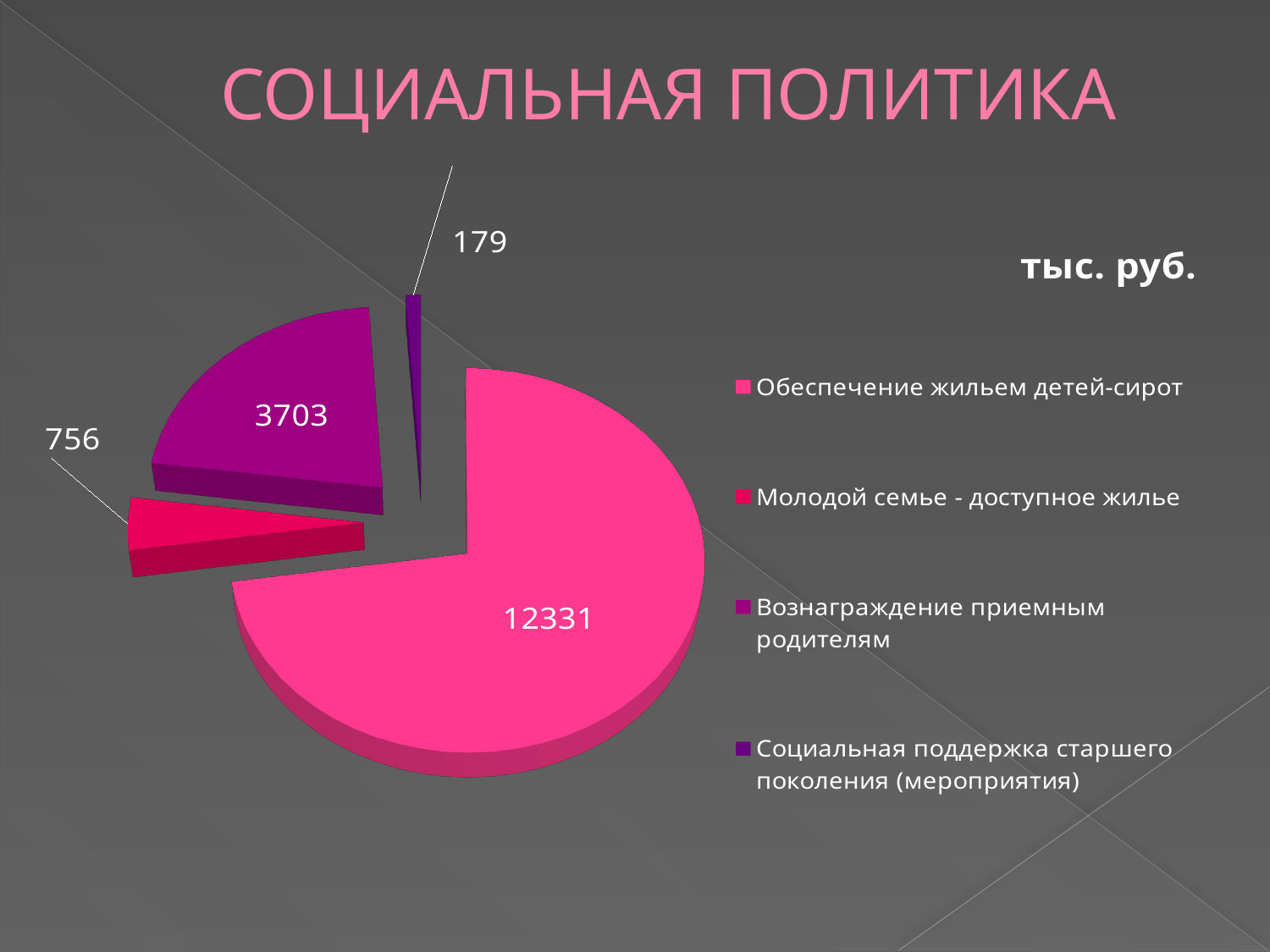
What is the difference between the values for Молодой семье - доступное жилье and Социальная поддержка старшего поколения (мероприятия)? 577 Which category has the smallest slice of the pie? Социальная поддержка старшего поколения (мероприятия) What is the value for Молодой семье - доступное жилье? 756 What type of chart is shown on the slide? Pie chart What is the difference between the values for Обеспечение жильем детей-сирот and Вознаграждение приемным родителям? 8628 How many slices does the pie chart have? 4 What is the value for Вознаграждение приемным родителям? 3703 Which is larger: the value for Вознаграждение приемным родителям or the value for Молодой семье - доступное жилье? Вознаграждение приемным родителям What is the value for Социальная поддержка старшего поколения (мероприятия)? 179 What unit is indicated for the values on the chart? тыс. руб. Which category has the largest slice of the pie? Обеспечение жильем детей-сирот What is the value for Обеспечение жильем детей-сирот? 12331